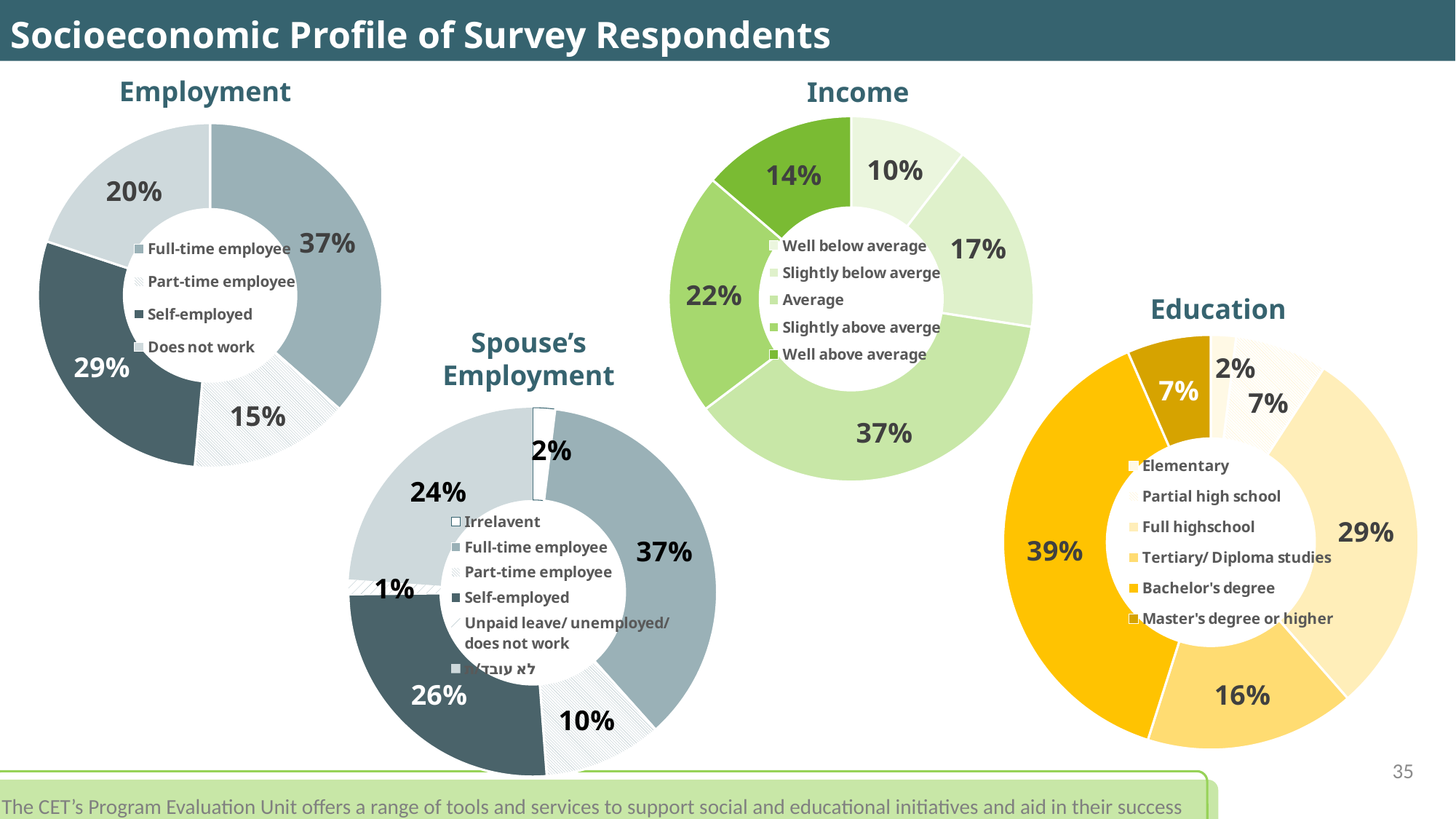
In the Income chart, which category has the largest share? Average In the Education chart, which is larger: Full highschool or Tertiary/ Diploma studies? Full highschool In the Income chart, what percentage of respondents report income well above average? 14% In the Spouse's Employment chart, what percentage of spouses are self-employed? 26% How many categories does the legend of the Income chart list? 5 In the Employment chart, what percentage of respondents are full-time employees? 37% What type of chart is used for the Education data? Pie chart (donut) In the Income chart, what is the difference between the Average share and the Well below average share? 27% In the Employment chart, what percentage of respondents are self-employed? 29% In the Education chart, which category has the smallest share? Elementary In the Employment chart, which category has the smallest share? Part-time employee In the Education chart, what percentage of respondents hold a Bachelor's degree? 39%